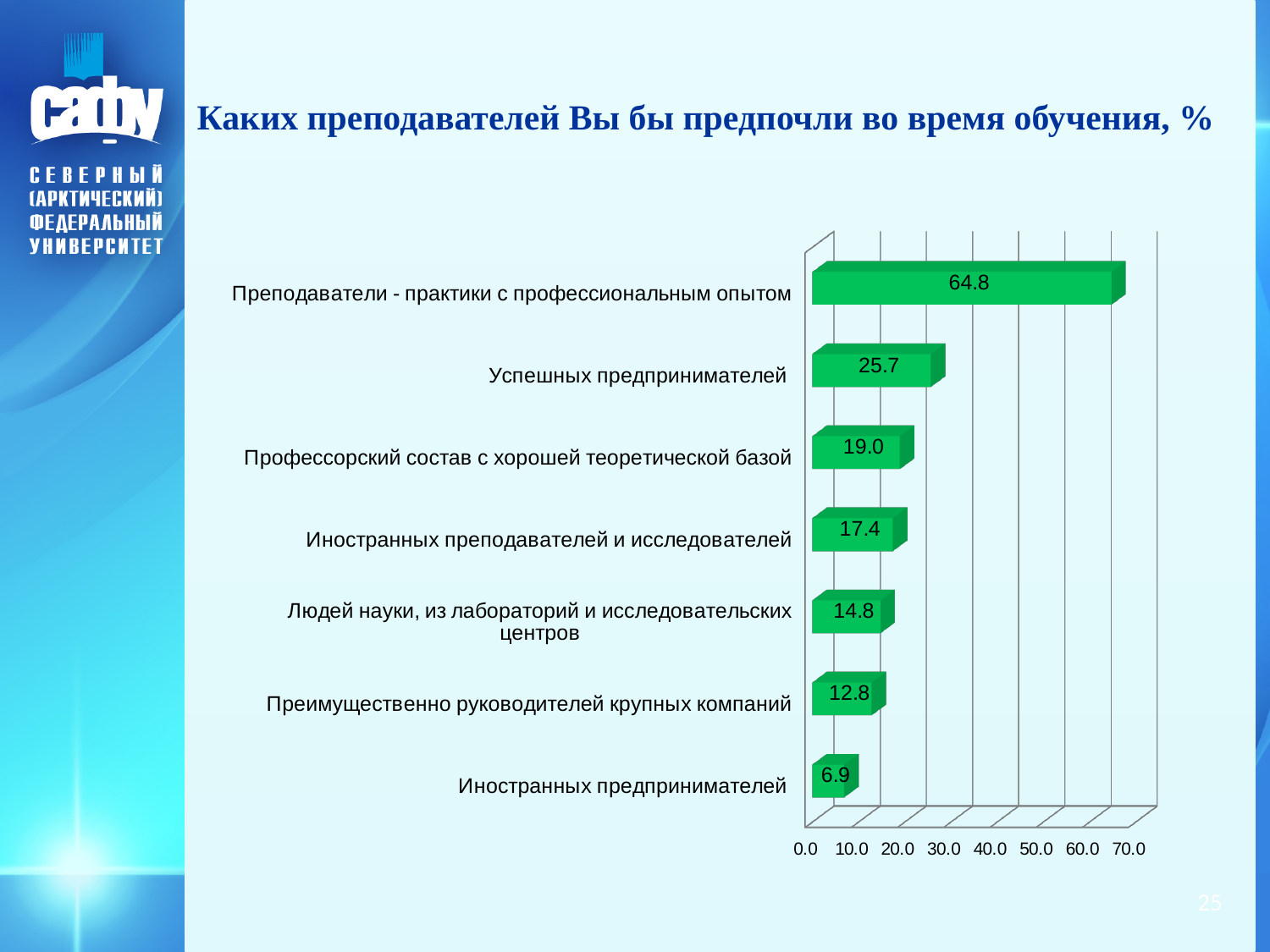
Which category has the lowest value? Иностранных предпринимателей Which category has the highest value? Преподаватели - практики с профессиональным опытом What is the value for "Успешных предпринимателей"? 25.7 Is the value for "Преимущественно руководителей крупных компаний" greater or less than 20.0? less What is the value for "Иностранных преподавателей и исследователей"? 17.4 How many categories are shown in the chart? 7 What is the value for "Иностранных предпринимателей"? 6.9 What kind of chart is shown on the slide? bar chart What is the difference between the values for "Преподаватели - практики с профессиональным опытом" and "Успешных предпринимателей"? 39.1 What is the title of the slide? Каких преподавателей Вы бы предпочли во время обучения, % Which is larger: the value for "Профессорский состав с хорошей теоретической базой" or for "Людей науки, из лабораторий и исследовательских центров"? Профессорский состав с хорошей теоретической базой What is the value for "Преподаватели - практики с профессиональным опытом"? 64.8